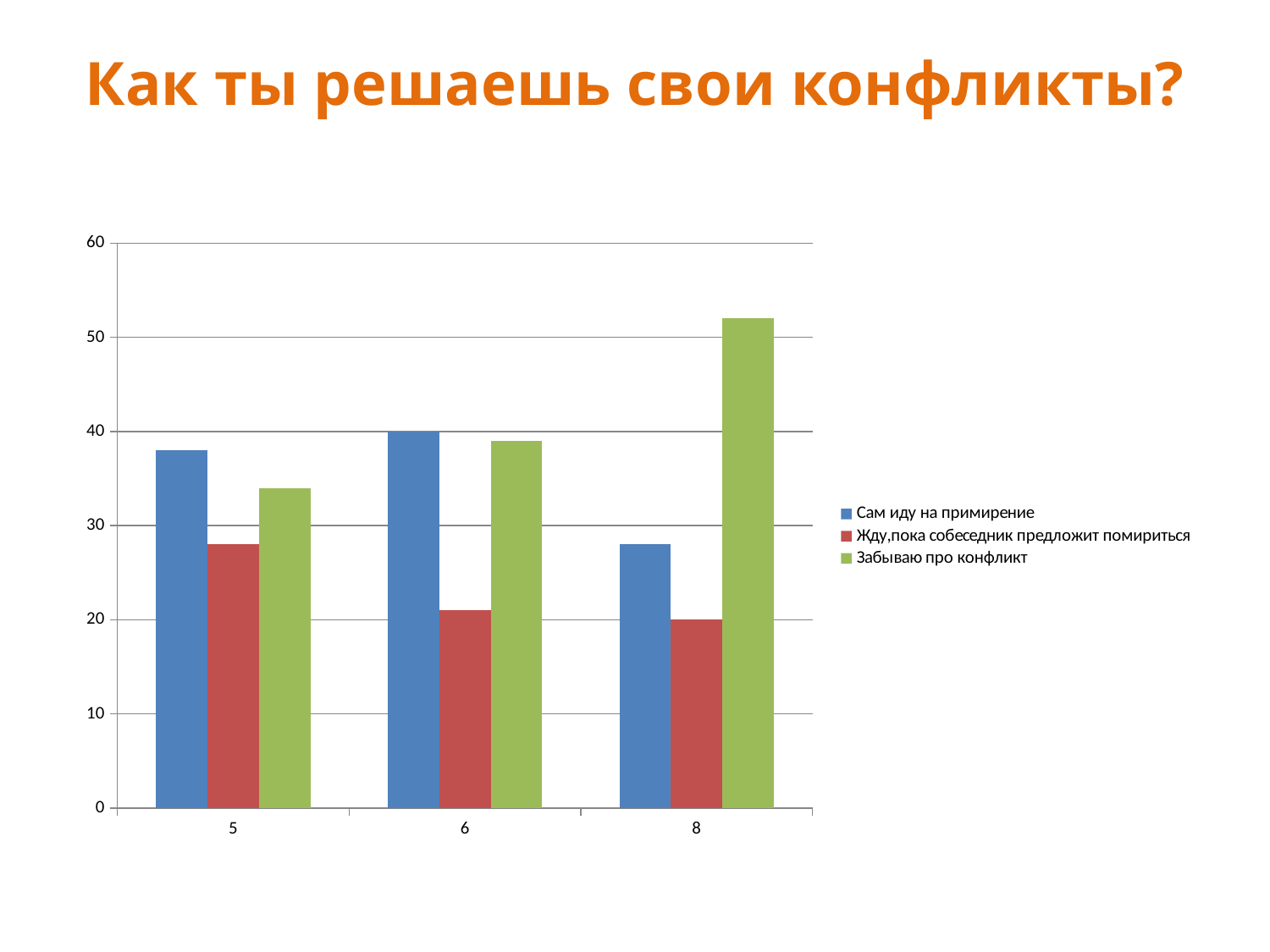
Is the value for 'Забываю про конфликт' in category 8 greater or less than 50? greater In which category is the value for 'Жду,пока собеседник предложит помириться' lowest? 8 In which category is the value for 'Забываю про конфликт' highest? 8 What is the value for 'Сам иду на примирение' in category 6? 40 How many categories are shown on the x axis? 3 Which series is shown in green in the legend? Забываю про конфликт What is the title of the chart? Как ты решаешь свои конфликты? What kind of chart is shown on the slide? bar chart Do the values for 'Жду,пока собеседник предложит помириться' rise or fall from category 5 to category 8? fall In category 8, which is larger: 'Сам иду на примирение' or 'Забываю про конфликт'? Забываю про конфликт What is the value for 'Жду,пока собеседник предложит помириться' in category 8? 20 How many series does the legend list? 3